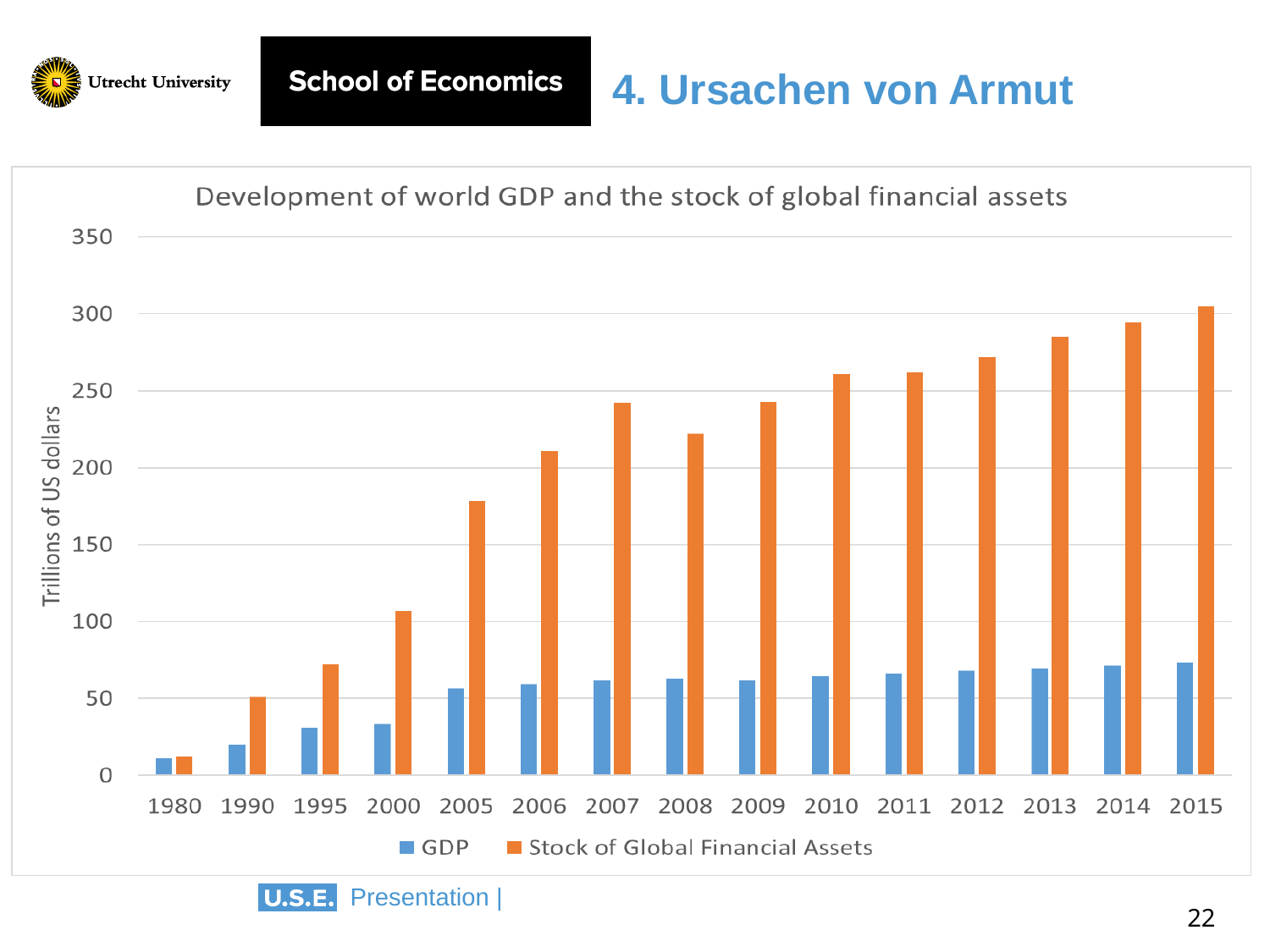
Do the values for Stock of Global Financial Assets generally rise or fall from 1980 to 2015? rise Which year has the highest value for Stock of Global Financial Assets? 2015 How many series does the legend list? 2 What kind of chart is shown on the slide? bar chart Which is larger: Stock of Global Financial Assets in 2007 or in 2008? 2007 What is the label of the y axis? Trillions of US dollars Is the value for Stock of Global Financial Assets in 2010 greater or less than 250? greater Is the value for Stock of Global Financial Assets in 2008 greater or less than 250? less How many years are shown on the x axis? 15 Which year has the lowest value for GDP? 1980 Is the value for Stock of Global Financial Assets in 2005 greater or less than 200? less